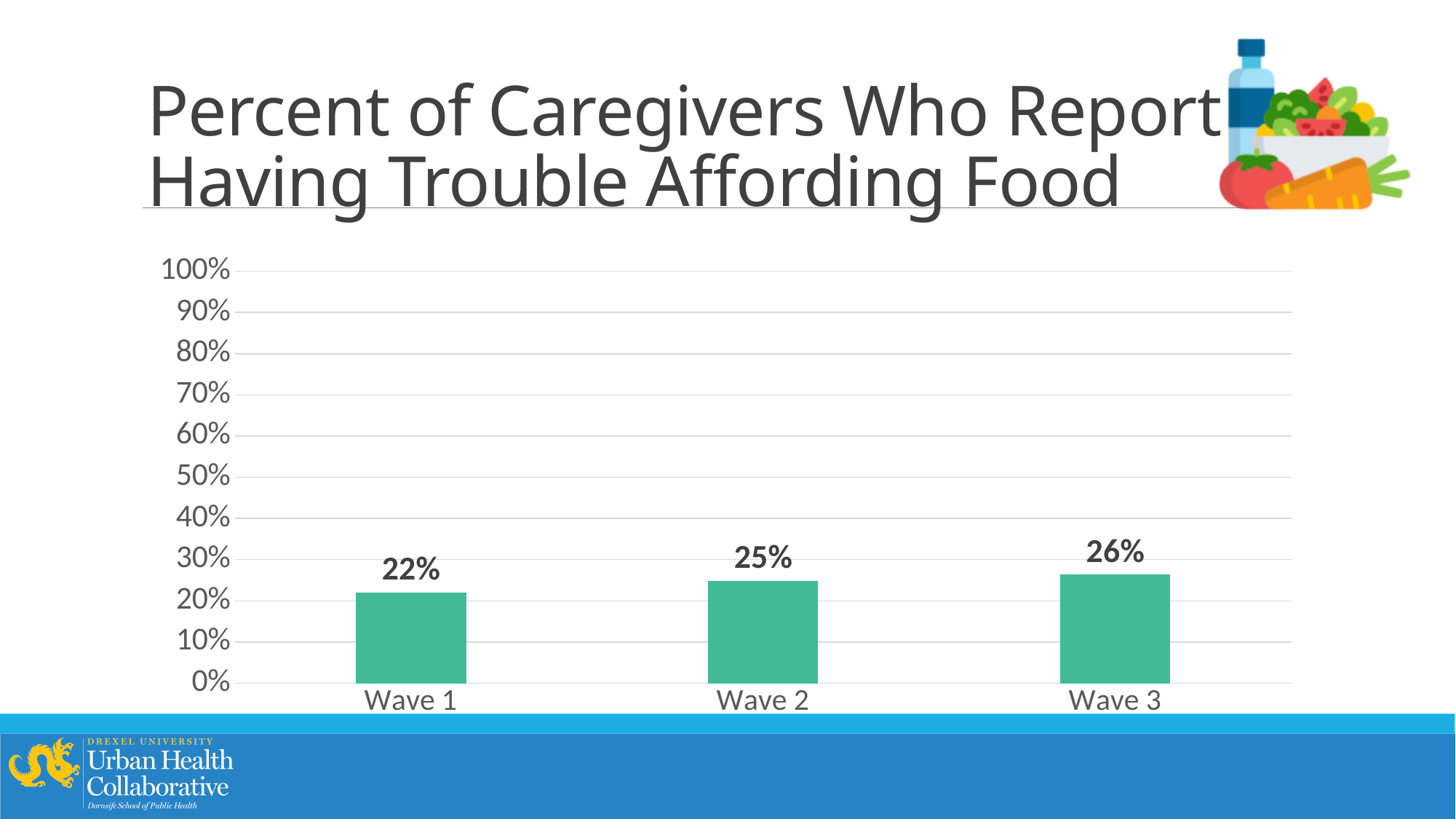
Which wave has the highest percent of caregivers reporting trouble affording food? Wave 3 Which is larger, the value for Wave 1 or the value for Wave 2? Wave 2 What is the value shown for Wave 3? 26% Is the value for Wave 3 greater or less than 30%? less What is the value shown for Wave 2? 25% How many waves are shown on the chart? 3 What is the difference in percentage points between Wave 3 and Wave 1? 4 percentage points What kind of chart is shown on the slide? Bar chart What is the difference between the Wave 2 and Wave 1 values? 3 percentage points What percent of caregivers reported having trouble affording food in Wave 1? 22% Do the values rise or fall from Wave 1 to Wave 3? Rise Which wave has the lowest percent of caregivers reporting trouble affording food? Wave 1